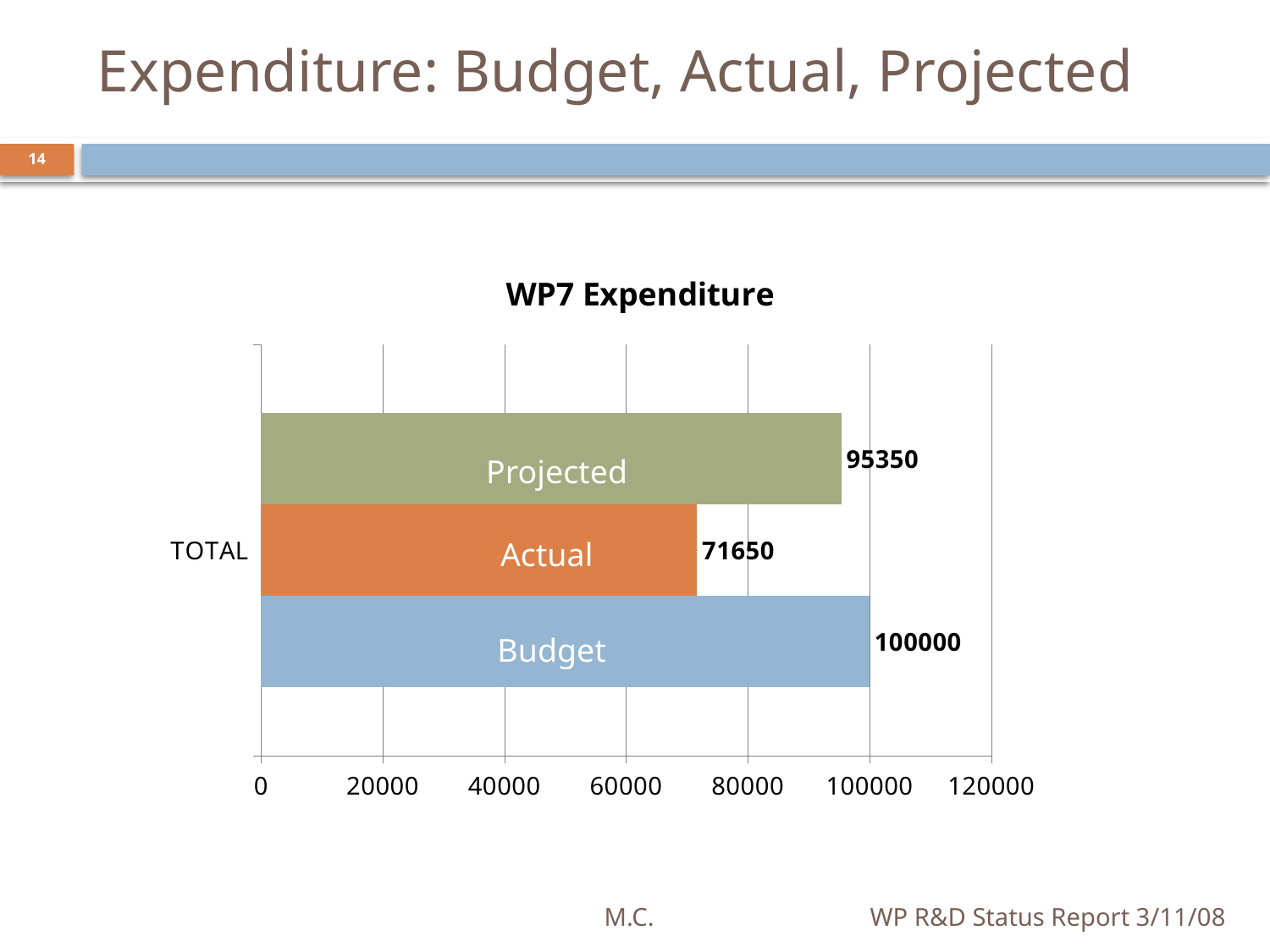
How many bars are shown in the WP7 Expenditure chart? 3 Which is larger, the Projected value or the Actual value? Projected Is the Actual value greater or less than 80000? less What is the Budget value in the WP7 Expenditure chart? 100000 What is the title of the chart on the slide? WP7 Expenditure What is the difference between the Budget and Actual values? 28350 What kind of chart is shown on the slide? bar chart Which series has the lowest value in the WP7 Expenditure chart? Actual Which series has the highest value in the WP7 Expenditure chart? Budget What is the difference between the Budget and Projected values? 4650 What is the Actual value in the WP7 Expenditure chart? 71650 What is the Projected value in the WP7 Expenditure chart? 95350